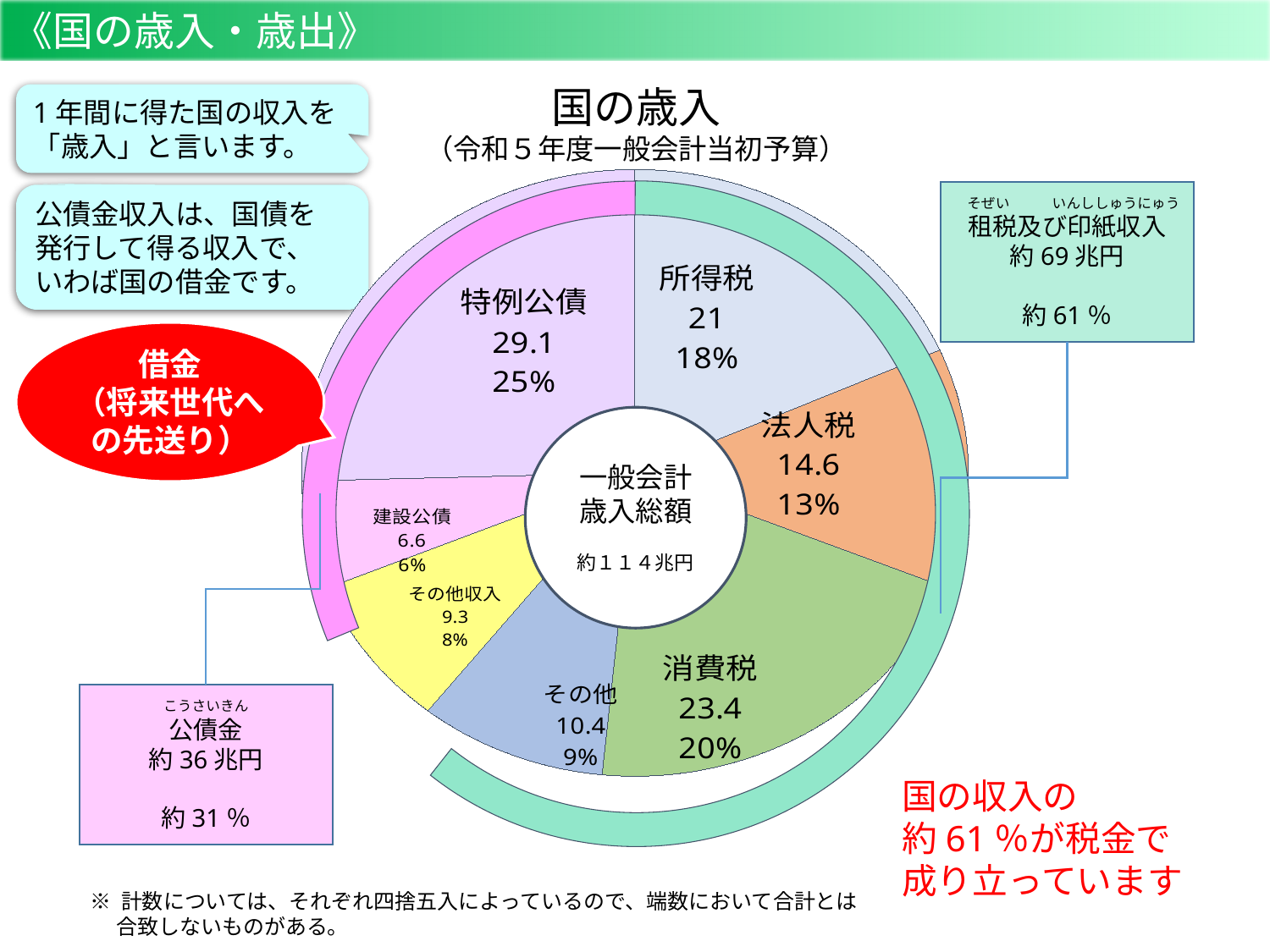
What percentage share does 特例公債 have in the pie chart? 25% What is the value shown for その他収入? 9.3 Which is larger, the value for 所得税 or the value for 法人税? 所得税 Which slice of the 国の歳入 pie chart is the smallest? 建設公債 What is the difference between the values for 特例公債 and 消費税? 5.7 What kind of chart is shown on the slide? pie chart How many slices does the 国の歳入 pie chart have? 7 What percentage share does 消費税 have in the 国の歳入 pie chart? 20% What is the value shown for 法人税? 14.6 What total is written in the centre of the pie chart for 一般会計歳入総額? 約１１４兆円 What is the value shown for 所得税 in the 国の歳入 pie chart? 21 Which slice of the 国の歳入 pie chart is the largest? 特例公債